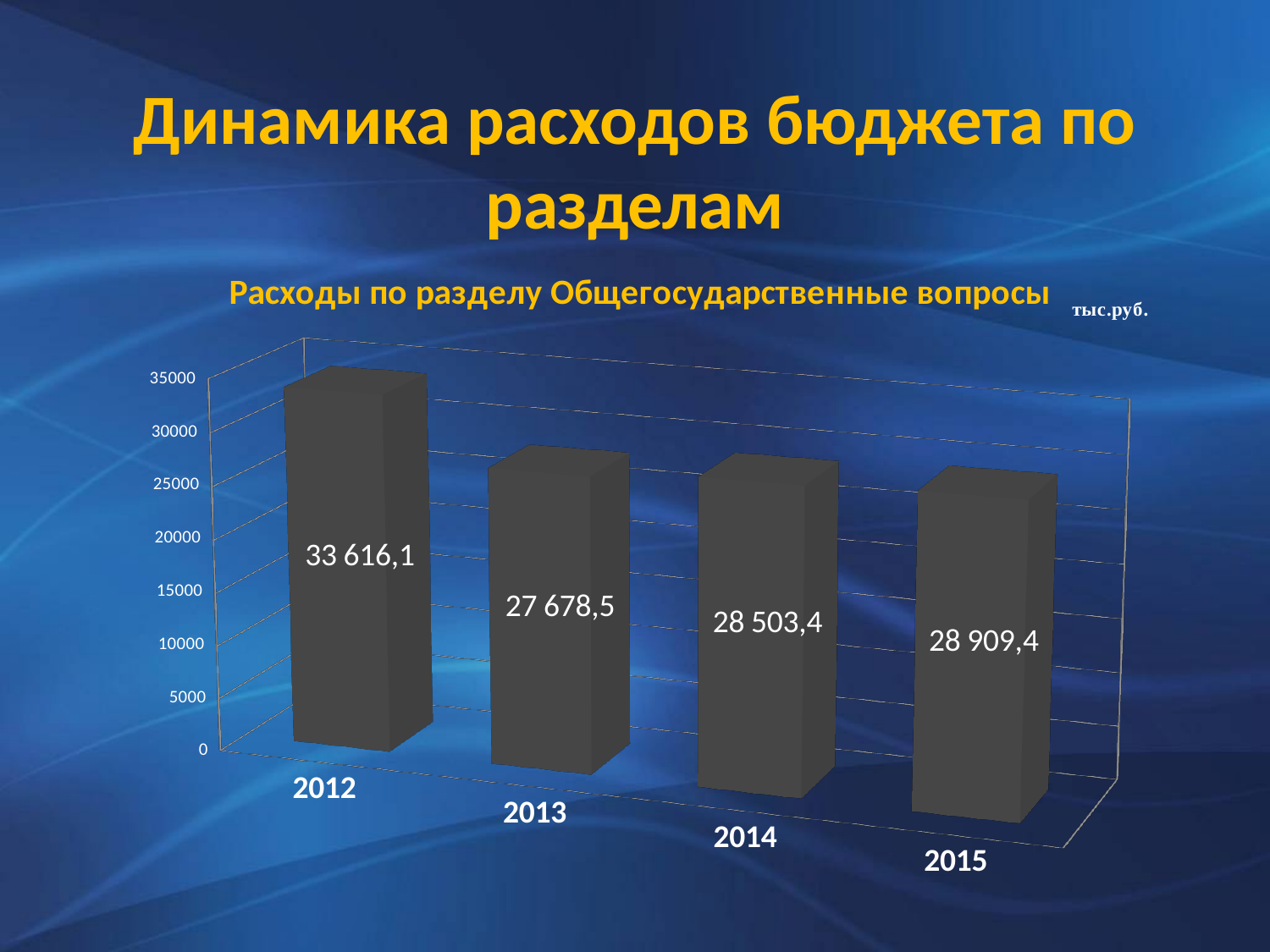
Is the value for 2013 greater or less than 30000? less Which year has the highest value in the chart? 2012 Which year has the lowest value in the chart? 2013 Do the values rise or fall from 2013 to 2015? rise What is the difference between the values for 2015 and 2014? 406,0 Which is larger, the value for 2014 or the value for 2015? 2015 What kind of chart is shown on the slide? bar chart What is the value for 2012 in the chart? 33 616,1 What is the value for 2013 in the chart? 27 678,5 How many years are shown in the chart? 4 What is the value for 2015 in the chart? 28 909,4 What is the difference between the values for 2012 and 2013? 5 937,6